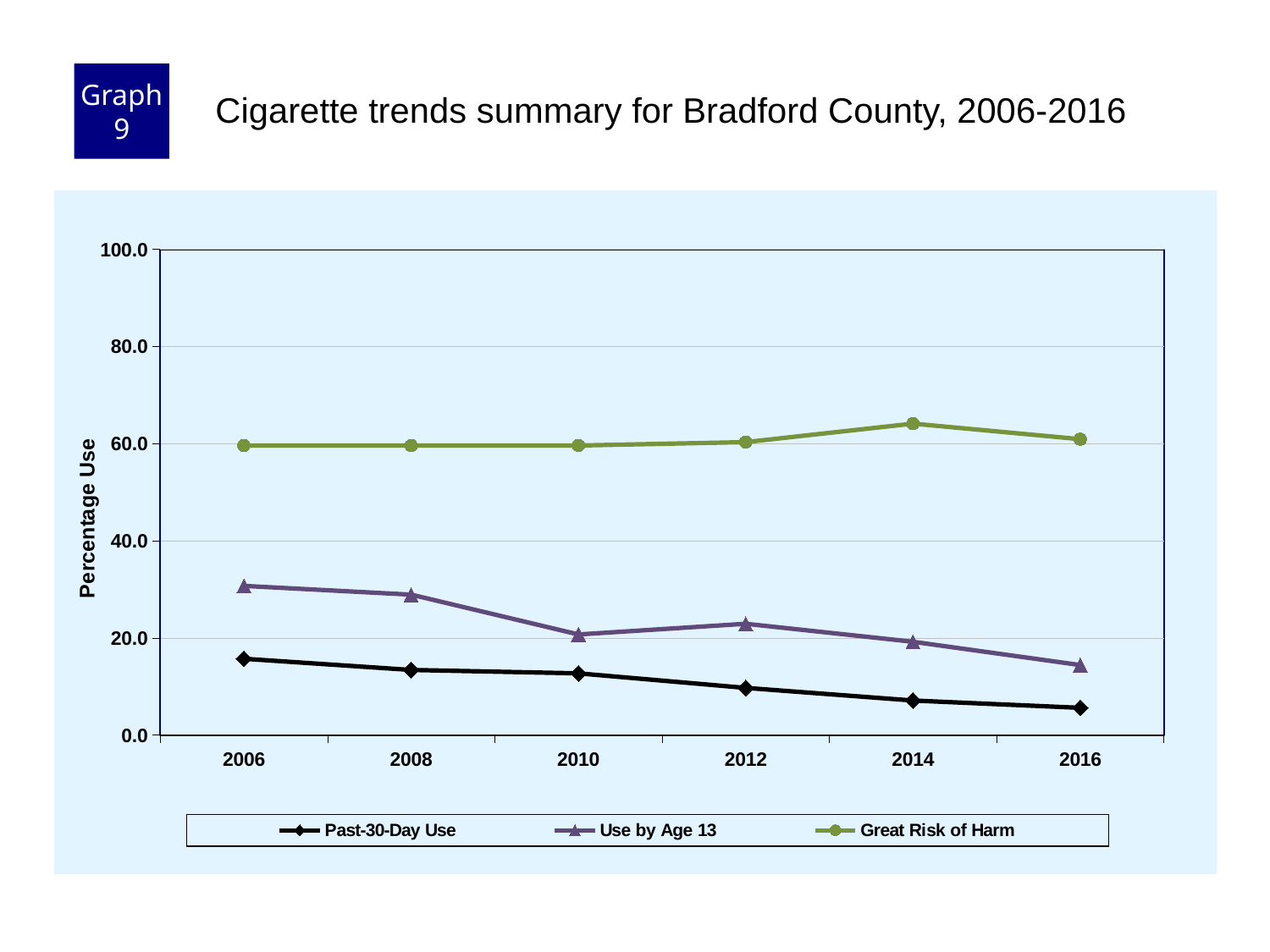
What kind of chart is shown on the slide? line chart Does the Use by Age 13 line rise or fall overall from 2006 to 2016? fall Is the value for Use by Age 13 in 2016 greater or less than 20.0? less Does the Past-30-Day Use line rise or fall from 2006 to 2016? fall How many years are plotted along the x axis? 6 What is the title of the chart? Cigarette trends summary for Bradford County, 2006-2016 How many series does the legend list? 3 Is the value for Great Risk of Harm in 2014 greater or less than 60.0? greater Is the value for Use by Age 13 in 2006 greater or less than 20.0? greater In 2016, which is higher, Use by Age 13 or Past-30-Day Use? Use by Age 13 In which year is Great Risk of Harm at its highest? 2014